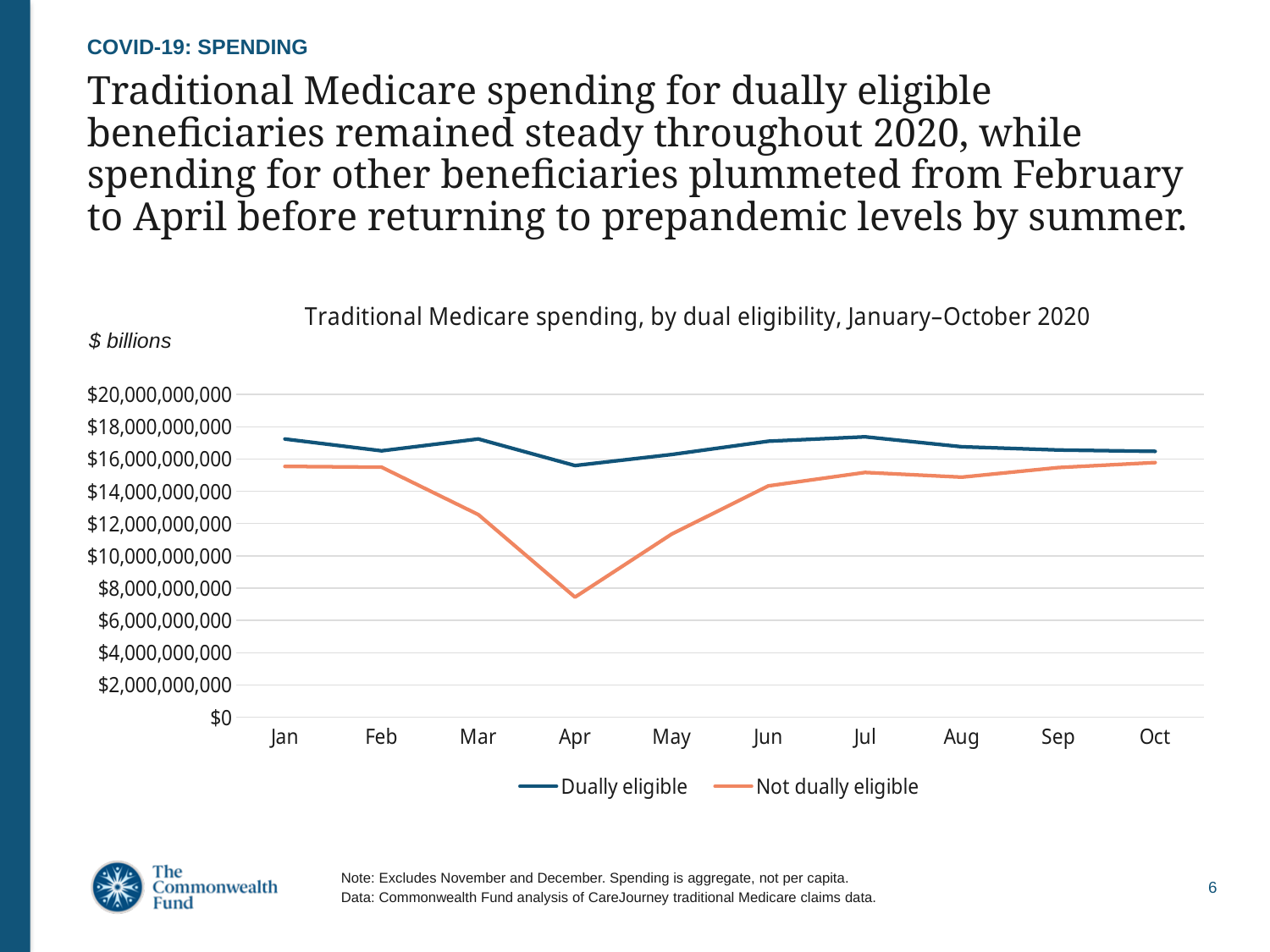
Is the value for Not dually eligible in May greater or less than $12,000,000,000? less Does the Not dually eligible series rise or fall from Apr to Jul? Rise In which month is the Not dually eligible series at its lowest? Apr Is the value for Dually eligible in Apr greater or less than $16,000,000,000? less What kind of chart is shown on the slide? Line chart What is the title of the chart? Traditional Medicare spending, by dual eligibility, January–October 2020 How many months are plotted along the x axis? 10 Does the Not dually eligible series rise or fall from Feb to Apr? Fall How many series does the legend list? 2 In Apr, which series has the higher value, Dually eligible or Not dually eligible? Dually eligible Is the value for Dually eligible in Jan greater or less than $16,000,000,000? greater